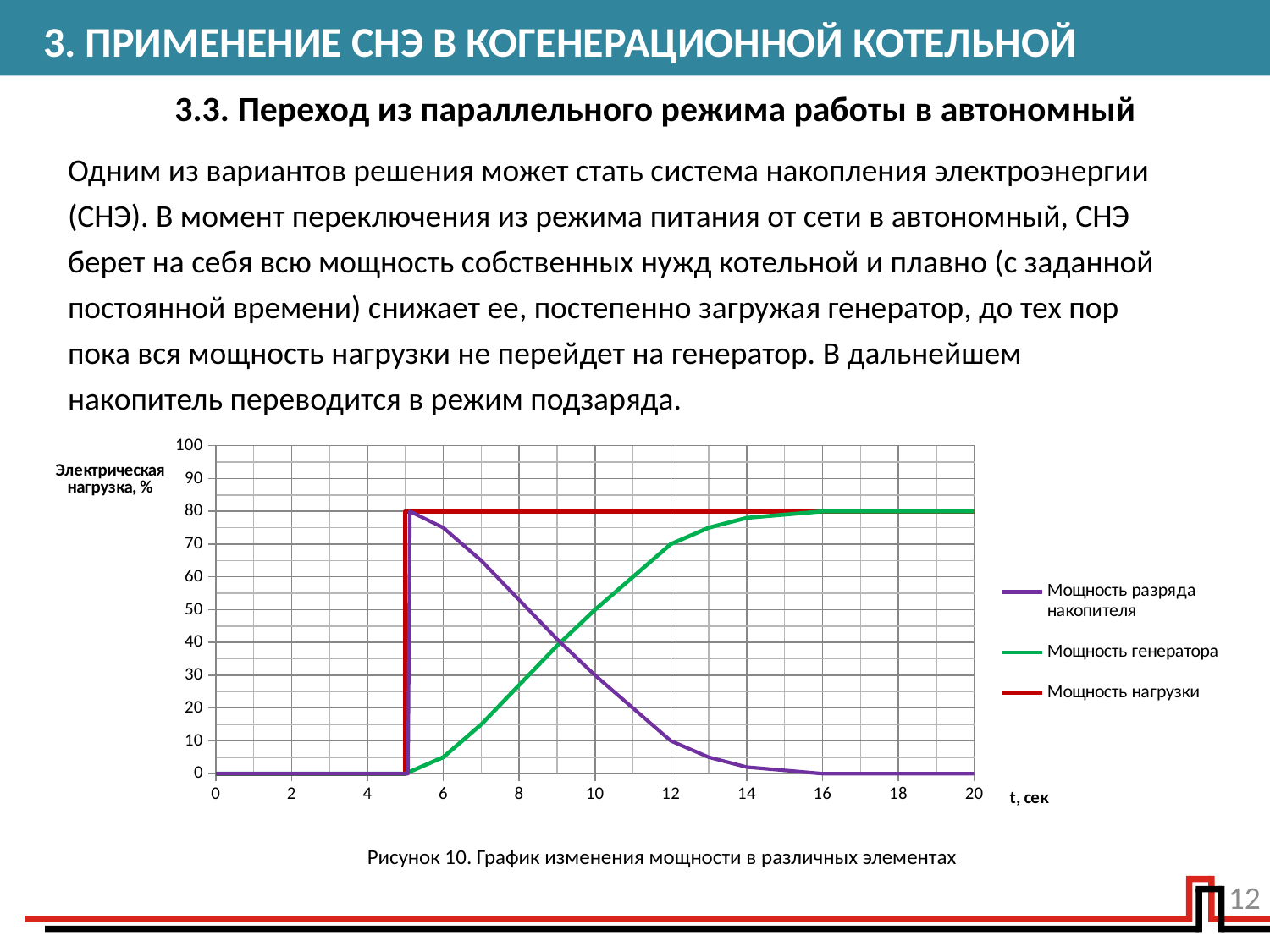
What kind of chart is shown on the slide? line chart What is the x-axis label of the chart? t, сек Is the value of Мощность генератора at t = 8 greater or less than 40? greater Does Мощность генератора rise or fall between t = 6 and t = 16? rise Is the value of Мощность разряда накопителя at t = 12 greater or less than 20? less At t = 6, which is larger: Мощность разряда накопителя or Мощность генератора? Мощность разряда накопителя What is the value of Мощность разряда накопителя at t = 2? 0 What is the value of Мощность нагрузки at t = 10? 80 Which series is drawn in red on the chart? Мощность нагрузки How many series does the chart legend list? 3 At t = 12, which is larger: Мощность генератора or Мощность разряда накопителя? Мощность генератора